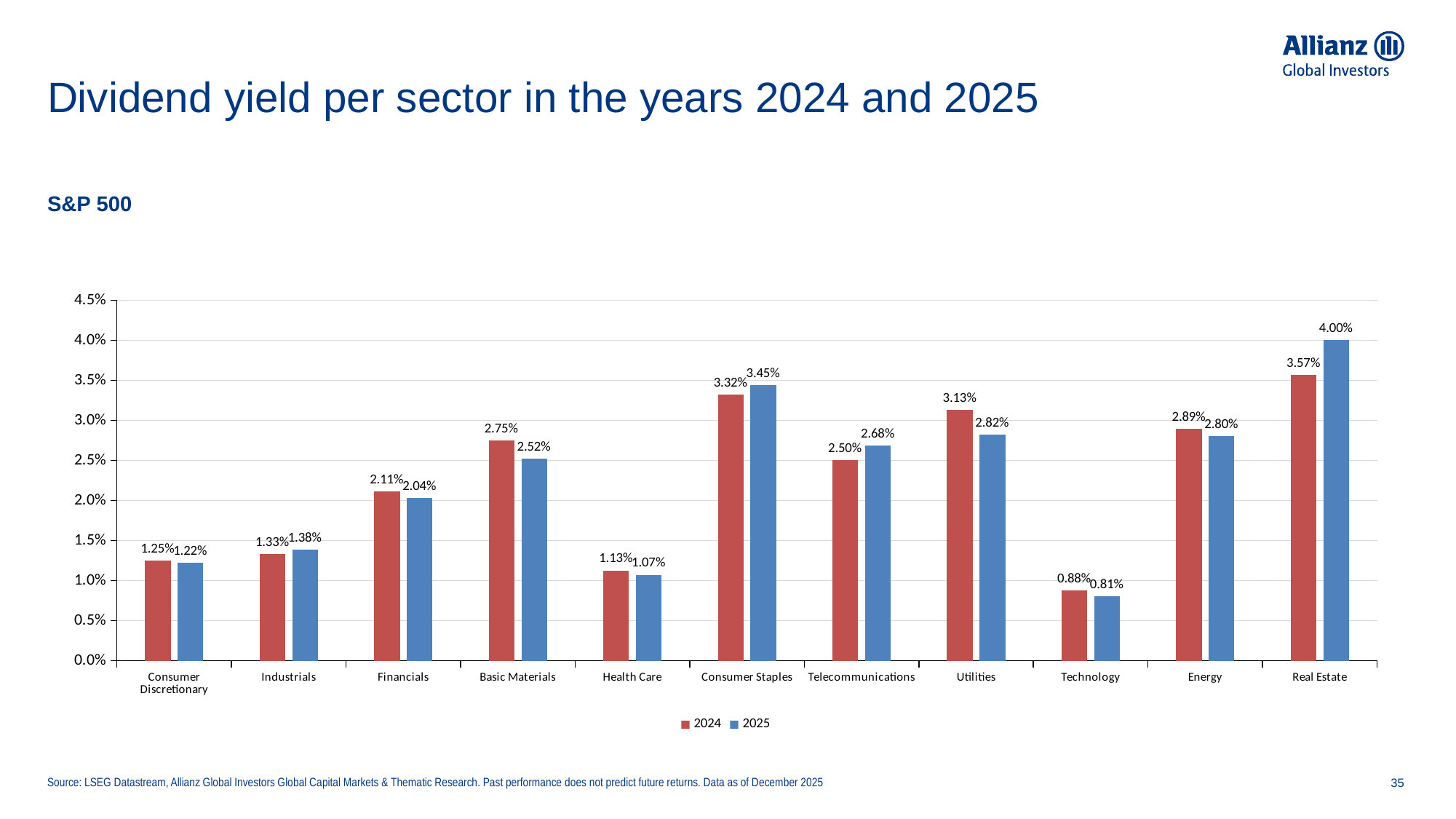
Which colour represents the 2025 series in the chart? Blue What is the difference between the 2025 and 2024 dividend yields for Real Estate? 0.43% What is the 2025 dividend yield for Real Estate? 4.00% How many series does the legend list? 2 What is the 2024 dividend yield for Utilities? 3.13% Is the 2024 dividend yield for Consumer Staples greater or less than 3.0%? greater What kind of chart is shown on the slide? Bar chart Which is larger for Basic Materials, the 2024 or the 2025 dividend yield? 2024 How many sectors are shown on the x axis? 11 Which sector has the lowest 2024 dividend yield? Technology What is the 2025 dividend yield for Telecommunications? 2.68% Which sector has the highest 2025 dividend yield? Real Estate